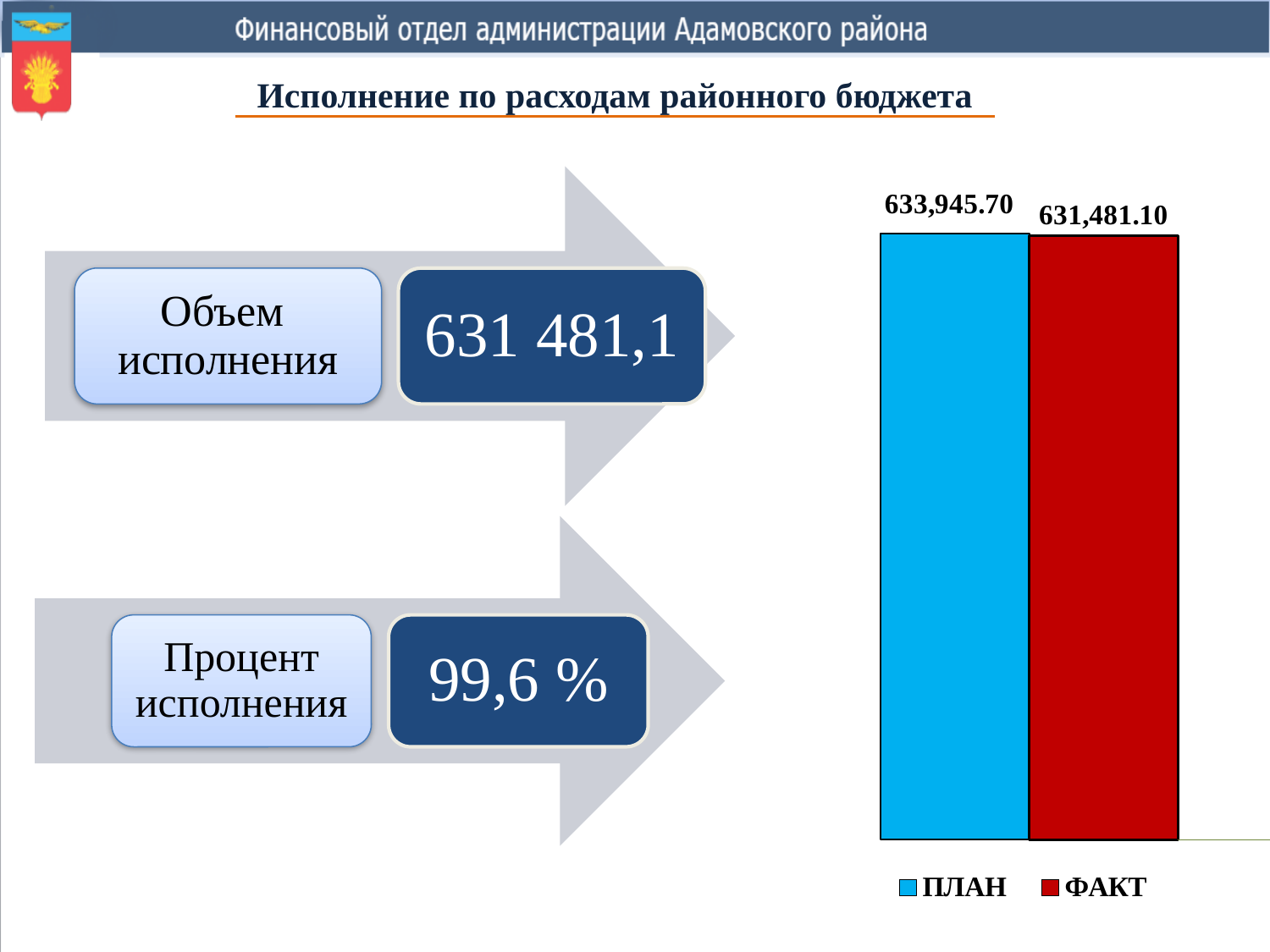
What kind of chart is shown on the slide? Bar chart What colour is the ФАКТ bar? Red What is the difference between the ПЛАН and ФАКТ values? 2,464.60 What is the value of the ПЛАН bar? 633,945.70 Which series has the lowest value in the chart? ФАКТ What is the value of the ФАКТ bar? 631,481.10 How many bars are plotted in the chart? 2 What colour is the ПЛАН bar? Blue Which bar has the higher value, ПЛАН or ФАКТ? ПЛАН Which series has the highest value in the chart? ПЛАН How many series does the legend list? 2